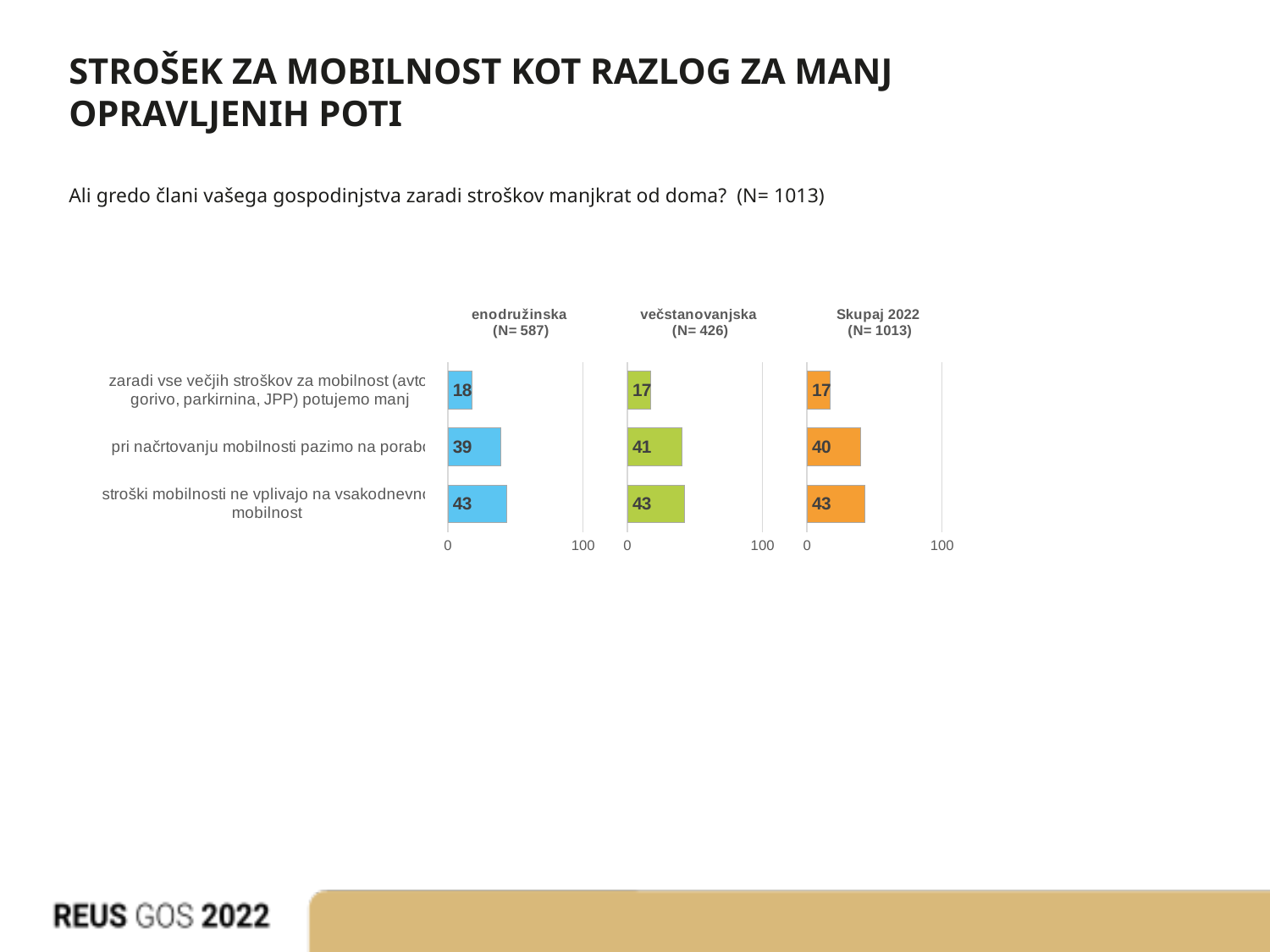
In the 'enodružinska (N= 587)' chart, which category has the lowest value? zaradi vse večjih stroškov za mobilnost (avto, gorivo, parkirnina, JPP) potujemo manj How many categories are shown in the 'Skupaj 2022 (N= 1013)' chart? 3 In the 'večstanovanjska (N= 426)' chart, what is the difference between the values for 'stroški mobilnosti ne vplivajo na vsakodnevno mobilnost' and 'zaradi vse večjih stroškov za mobilnost ... potujemo manj'? 26 In the 'večstanovanjska (N= 426)' chart, what is the value for 'pri načrtovanju mobilnosti pazimo na porabo'? 41 How many separate charts are shown on the slide? 3 In the 'enodružinska (N= 587)' chart, what is the value for 'stroški mobilnosti ne vplivajo na vsakodnevno mobilnost'? 43 Which is larger: the value for 'pri načrtovanju mobilnosti pazimo na porabo' in the 'enodružinska (N= 587)' chart or in the 'večstanovanjska (N= 426)' chart? večstanovanjska (N= 426) In the 'Skupaj 2022 (N= 1013)' chart, what is the value for 'zaradi vse večjih stroškov za mobilnost ... potujemo manj'? 17 What colour are the bars in the 'Skupaj 2022 (N= 1013)' chart? orange In the 'enodružinska (N= 587)' chart, what is the difference between the values for 'pri načrtovanju mobilnosti pazimo na porabo' and 'zaradi vse večjih stroškov za mobilnost ... potujemo manj'? 21 What type of chart is the 'enodružinska (N= 587)' chart? bar chart In the 'Skupaj 2022 (N= 1013)' chart, which category has the highest value? stroški mobilnosti ne vplivajo na vsakodnevno mobilnost